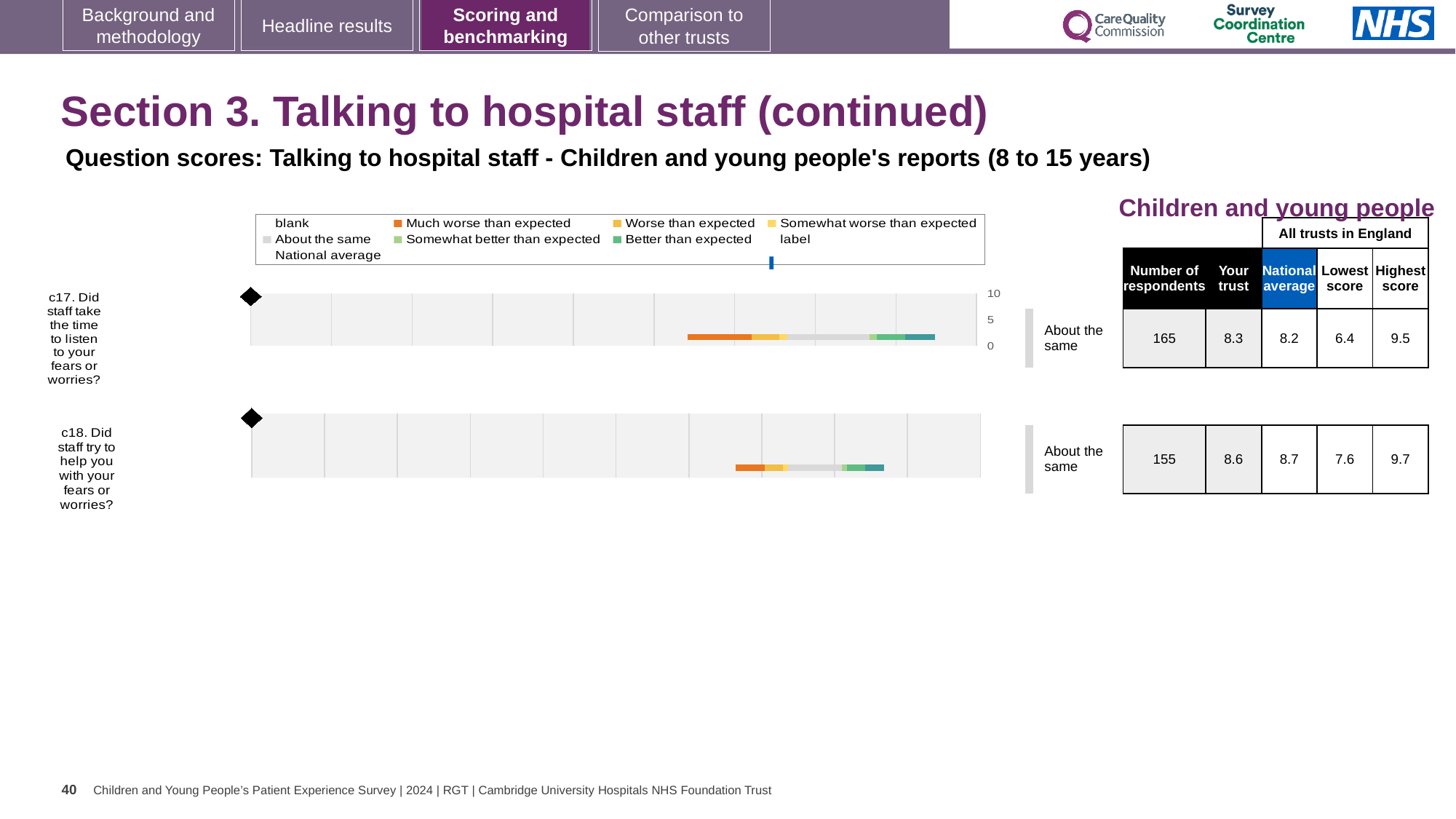
What is the 'Your trust' score for question c17 (Did staff take the time to listen to your fears or worries?)? 8.3 Which legend entry is shown in orange? Much worse than expected How many respondents answered question c17? 165 How many questions (categories) are plotted in the chart? 2 What benchmark category is shown for question c17? About the same What is the difference between the 'Your trust' score and the national average for question c18? 0.1 Which question has the higher 'Your trust' score, c17 or c18? c18 What is the difference between the highest score and the lowest score for question c17? 3.1 What is the 'Your trust' score for question c18 (Did staff try to help you with your fears or worries?)? 8.6 What is the national average score for question c17? 8.2 What is the highest score among all trusts in England for question c18? 9.7 What kind of chart is used to show the question scores on this slide? bar chart